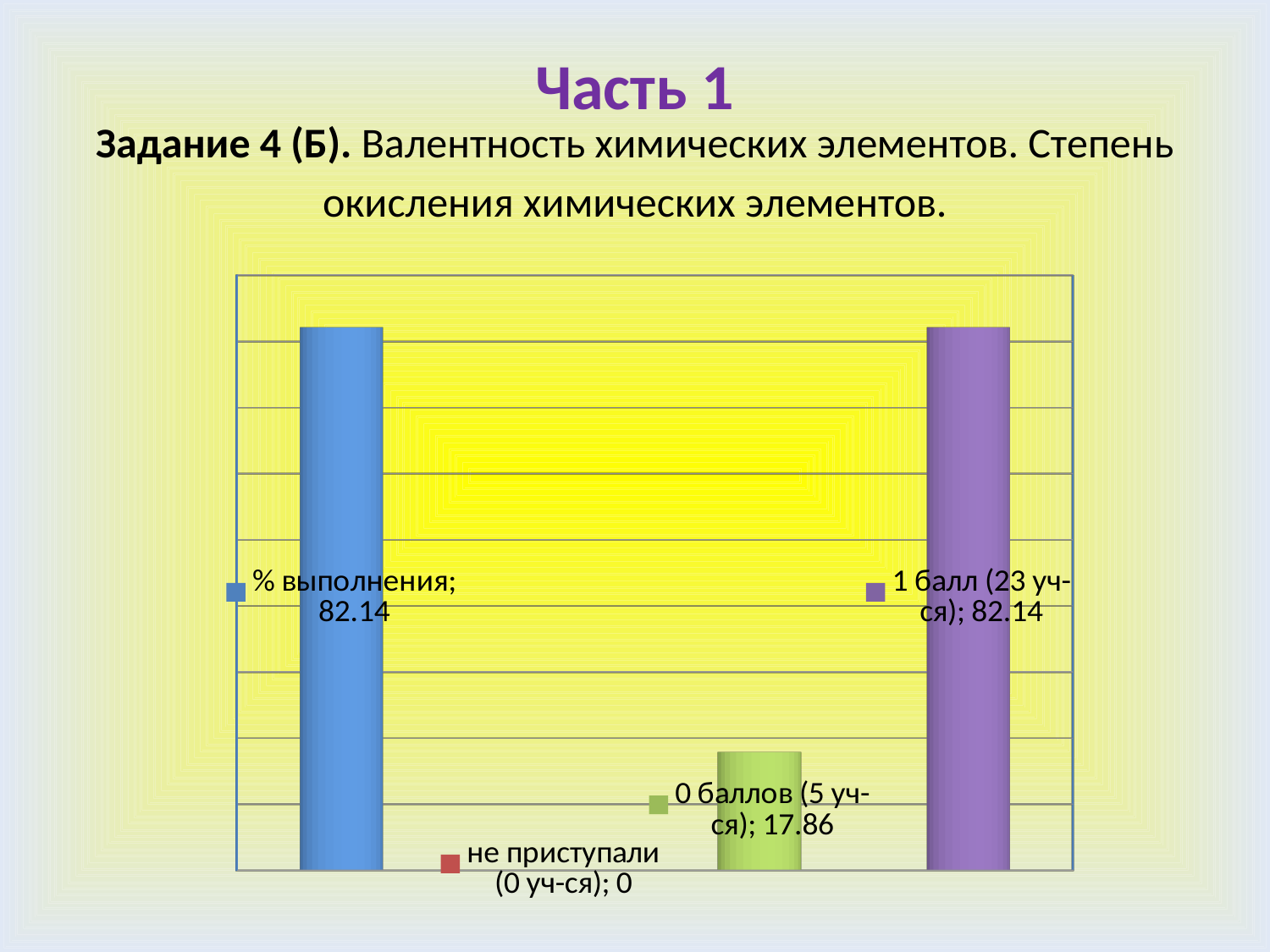
What is the value shown for "0 баллов (5 уч-ся)"? 17.86 What is the value shown for "1 балл (23 уч-ся)"? 82.14 What is the difference between the values for "1 балл (23 уч-ся)" and "0 баллов (5 уч-ся)"? 64.28 Which is larger: the value for "0 баллов (5 уч-ся)" or for "1 балл (23 уч-ся)"? 1 балл (23 уч-ся) How many categories are plotted in the chart? 4 What kind of chart is shown on the slide? bar chart What is the value shown for "не приступали (0 уч-ся)"? 0 What colour is the bar for "% выполнения"? blue What is the value shown for "% выполнения"? 82.14 How many students are indicated in the label for "1 балл"? 23 Which category has the lowest value? не приступали (0 уч-ся) What colour is the bar for "0 баллов (5 уч-ся)"? green